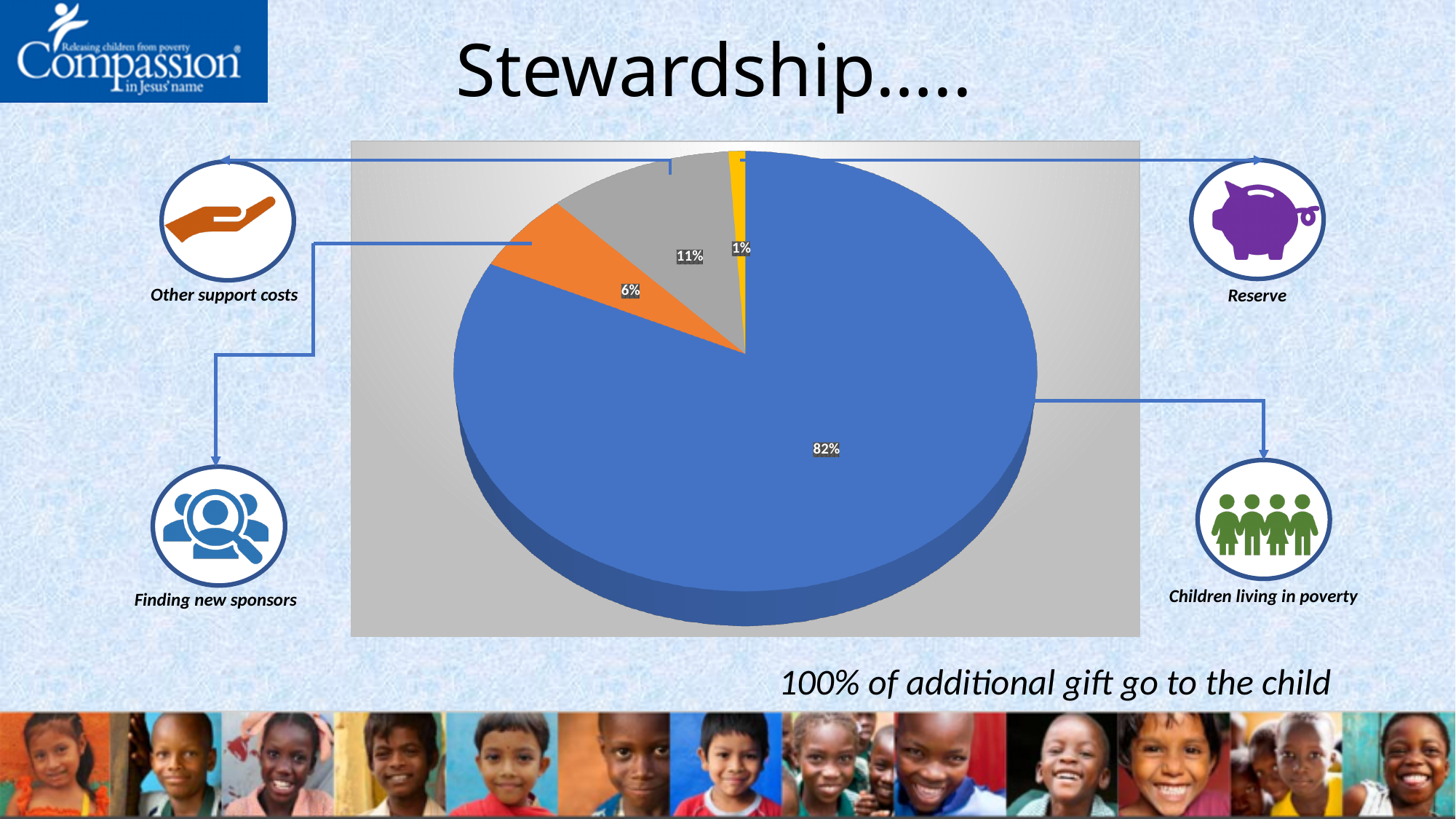
What percentage of the pie is Other support costs? 11% What percentage of the pie is Finding new sponsors? 6% Which category has the largest slice of the pie? Children living in poverty What kind of chart is shown on the slide? pie chart What is the difference in percentage points between Other support costs and Finding new sponsors? 5 What percentage of the pie goes to Children living in poverty? 82% Which category has the smallest slice of the pie? Reserve Which is larger, the slice for Other support costs or the slice for Finding new sponsors? Other support costs What is the title of the slide containing the pie chart? Stewardship..... What percentage of the pie is Reserve? 1% What colour is the slice for Children living in poverty? blue How many slices does the pie chart have? 4